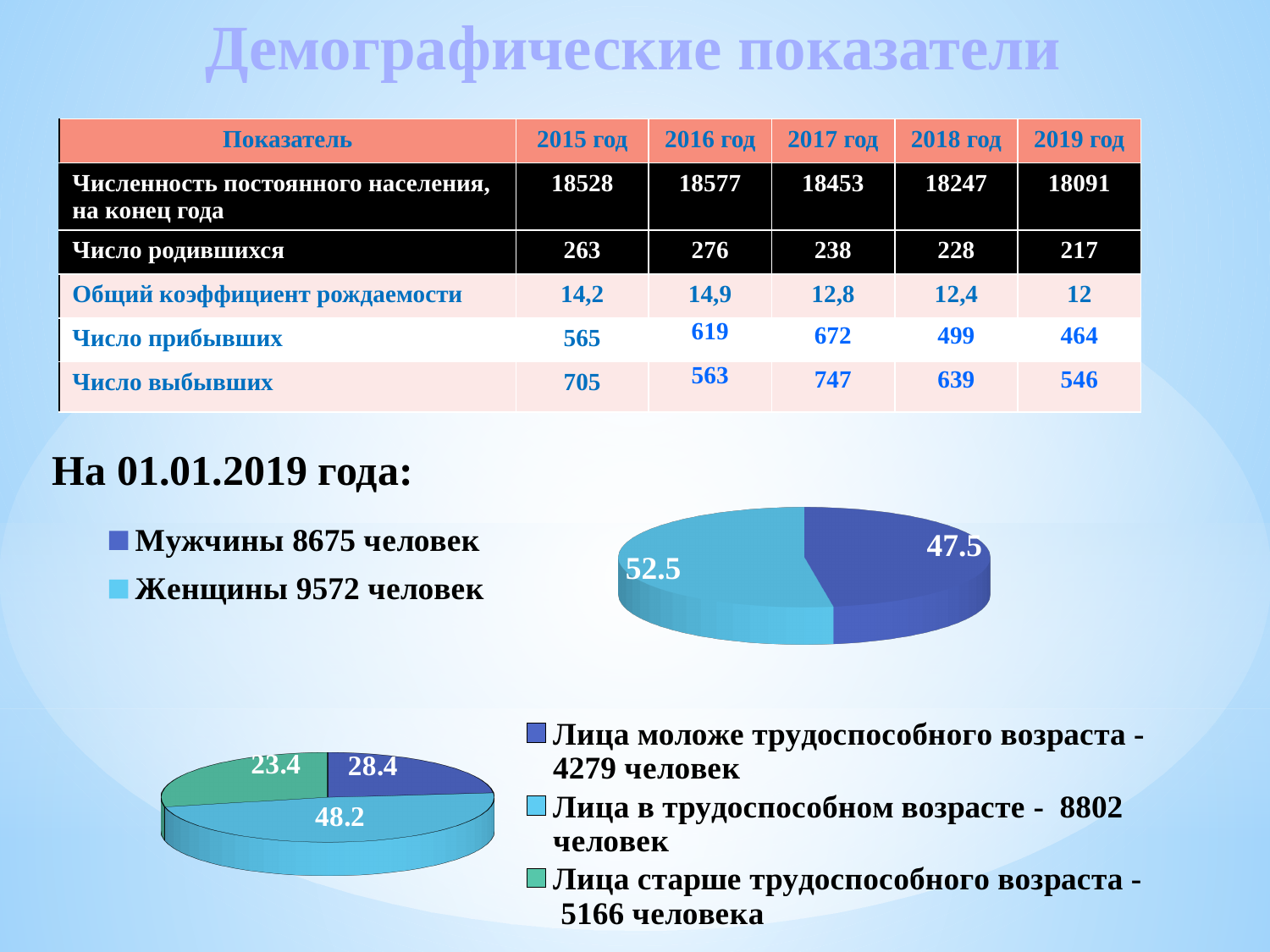
In the lower pie chart, what value is shown for 'Лица старше трудоспособного возраста'? 23.4 In the upper pie chart, which slice is larger, 'Мужчины' or 'Женщины'? Женщины In the lower pie chart, what value is shown for 'Лица в трудоспособном возрасте'? 48.2 What kind of chart is the upper chart on the slide (next to 'Мужчины' and 'Женщины')? pie chart In the lower pie chart, which category has the smallest slice? Лица старше трудоспособного возраста In the upper pie chart, what is the difference between the 'Женщины' and 'Мужчины' values? 5 In the lower pie chart, which category has the largest slice? Лица в трудоспособном возрасте How many entries does the legend of the upper pie chart list? 2 How many slices does the lower pie chart have? 3 In the upper pie chart, what value is shown for the 'Мужчины' slice? 47.5 In the lower pie chart, what value is shown for 'Лица моложе трудоспособного возраста'? 28.4 In the upper pie chart, what value is shown for the 'Женщины' slice? 52.5